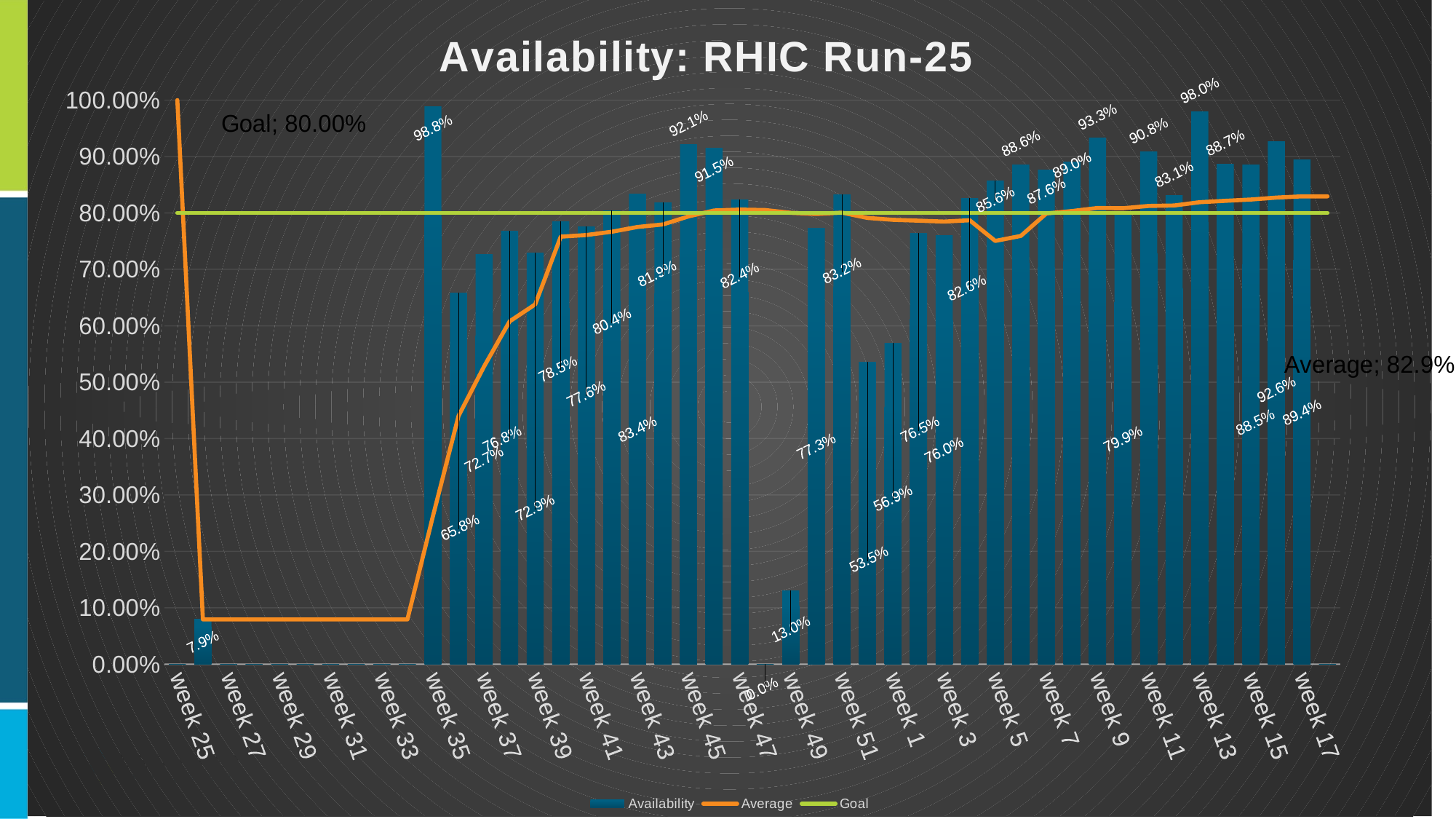
Is the availability value for week 1 greater or less than 70%? less Is the availability value for week 13 greater or less than 90%? greater What is the Goal value shown on the chart? 80.00% What kind of chart is used to show the Availability series? bar chart How many series does the legend list? 3 What is the title of the chart? Availability: RHIC Run-25 What is the highest availability value shown on the chart? 98.8% Which has the larger availability, week 25 or week 35? week 35 What is the Average value shown on the chart? 82.9% What is the availability value for week 25? 0.0% By how much does the Average (82.9%) exceed the Goal (80.00%)? 2.9 percentage points